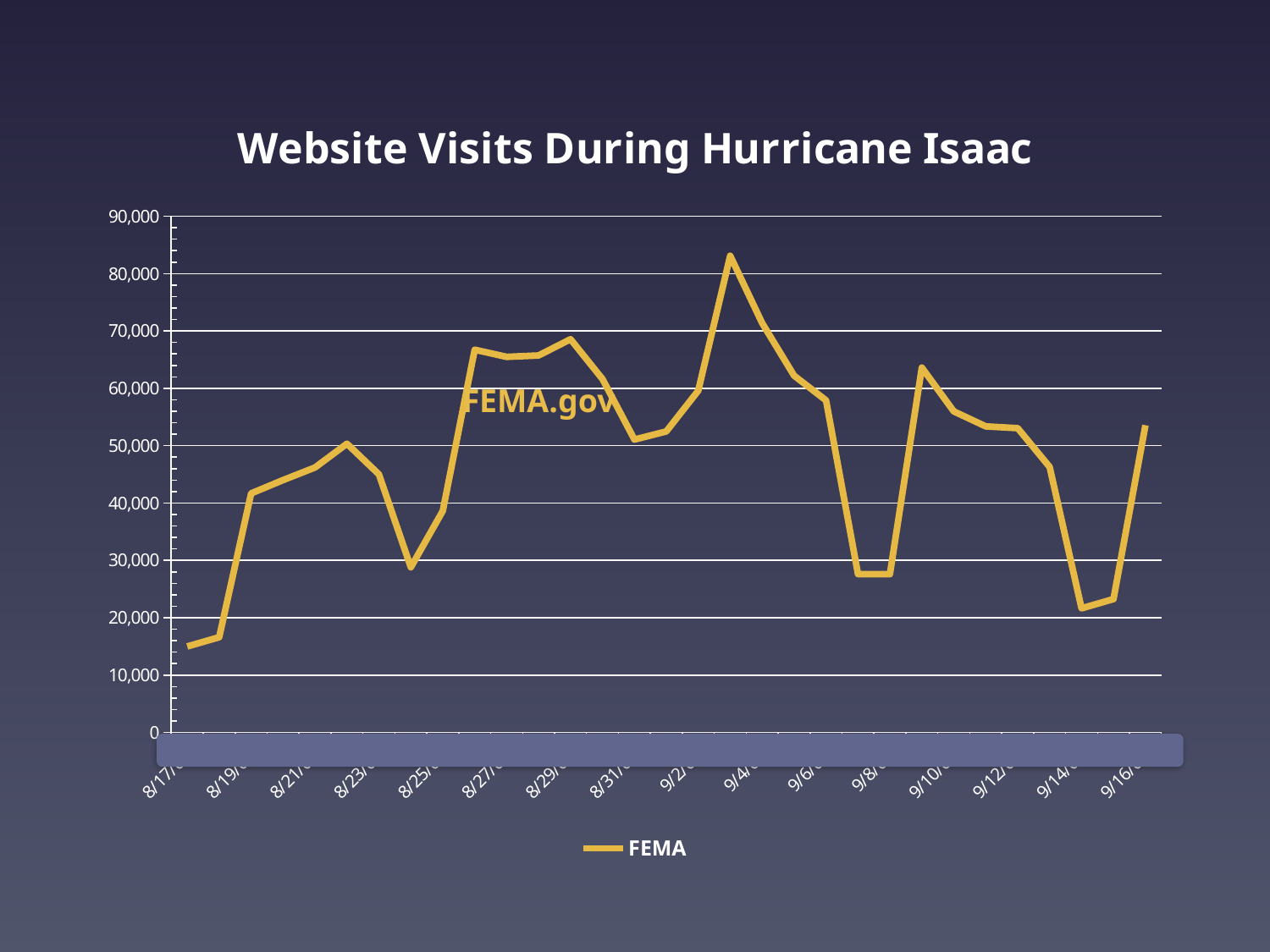
How many series does the legend list? 1 What kind of chart is shown on the slide? Line chart Which is larger, the value for 8/17 or the value for 9/16? 9/16 Do the values rise or fall between 8/17 and 8/21? rise Which date has the lowest value on the line? 8/17 What is the name of the series shown in the legend? FEMA Is the value for 9/8 greater or less than 30,000? less Is the value for 8/17 greater or less than 20,000? less What is the title of the chart? Website Visits During Hurricane Isaac How many date labels are shown along the x axis? 16 Is the value for 8/27 greater or less than 60,000? greater